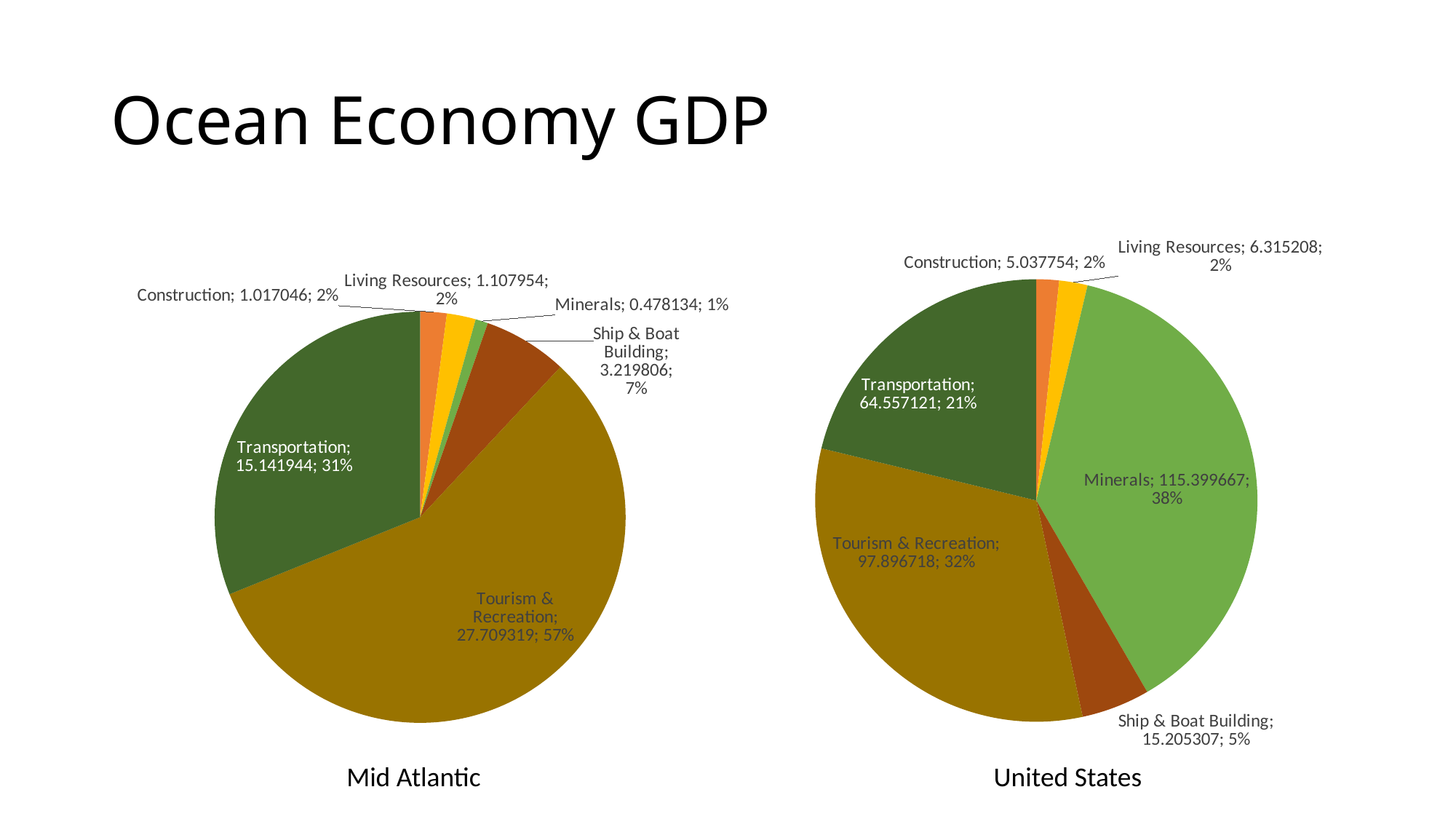
What type of chart is used for the Mid Atlantic data? Pie chart In the United States chart, what value is shown for Minerals? 115.399667 In the Mid Atlantic chart, what is the difference between the Tourism & Recreation and Transportation percentages? 26% In the Mid Atlantic chart, what share of the pie does Tourism & Recreation take? 57% In the United States chart, which is larger, Transportation or Tourism & Recreation? Tourism & Recreation What is the title of the slide containing the two charts? Ocean Economy GDP In the Mid Atlantic chart, which category has the smallest slice? Minerals How many categories are shown in the United States pie chart? 6 In the United States chart, what share of the pie does Ship & Boat Building take? 5% In the Mid Atlantic chart, which category has the largest slice? Tourism & Recreation In the Mid Atlantic chart, what value is shown for Transportation? 15.141944 In the United States chart, which category has the largest slice? Minerals